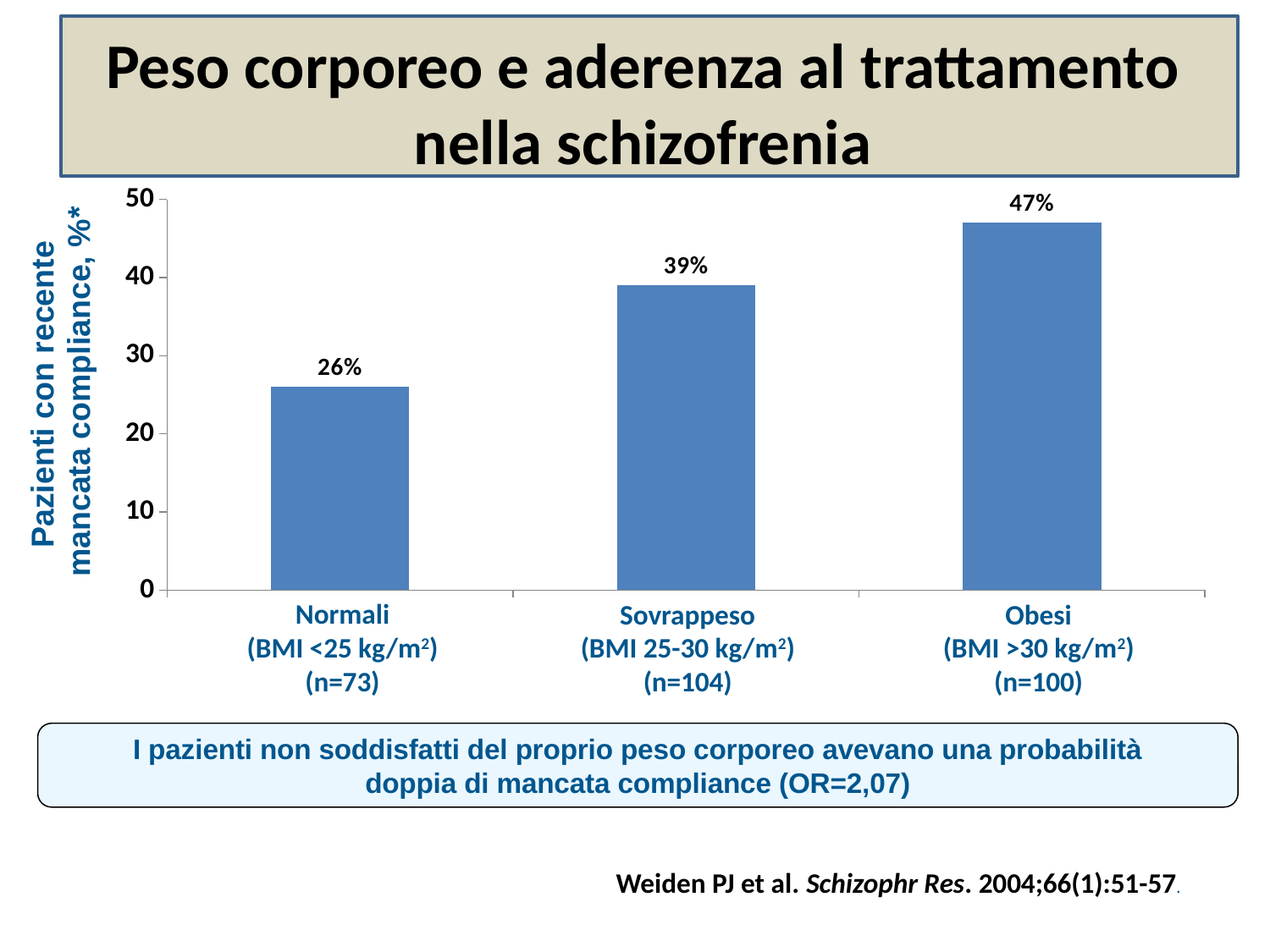
How many categories are shown on the x axis? 3 Do the values rise or fall from Normali to Obesi along the x axis? rise What is the value for Normali (BMI <25 kg/m2)? 26% What is the value for Sovrappeso (BMI 25-30 kg/m2)? 39% Which category has the lowest value? Normali What is the value for Obesi (BMI >30 kg/m2)? 47% Is the value for Sovrappeso greater or less than 30? greater Which is larger, the value for Sovrappeso or the value for Obesi? Obesi What is the difference between the values for Obesi and Normali? 21% What kind of chart is shown on the slide? bar chart Which category has the highest value? Obesi What is the difference between the values for Sovrappeso and Normali? 13%